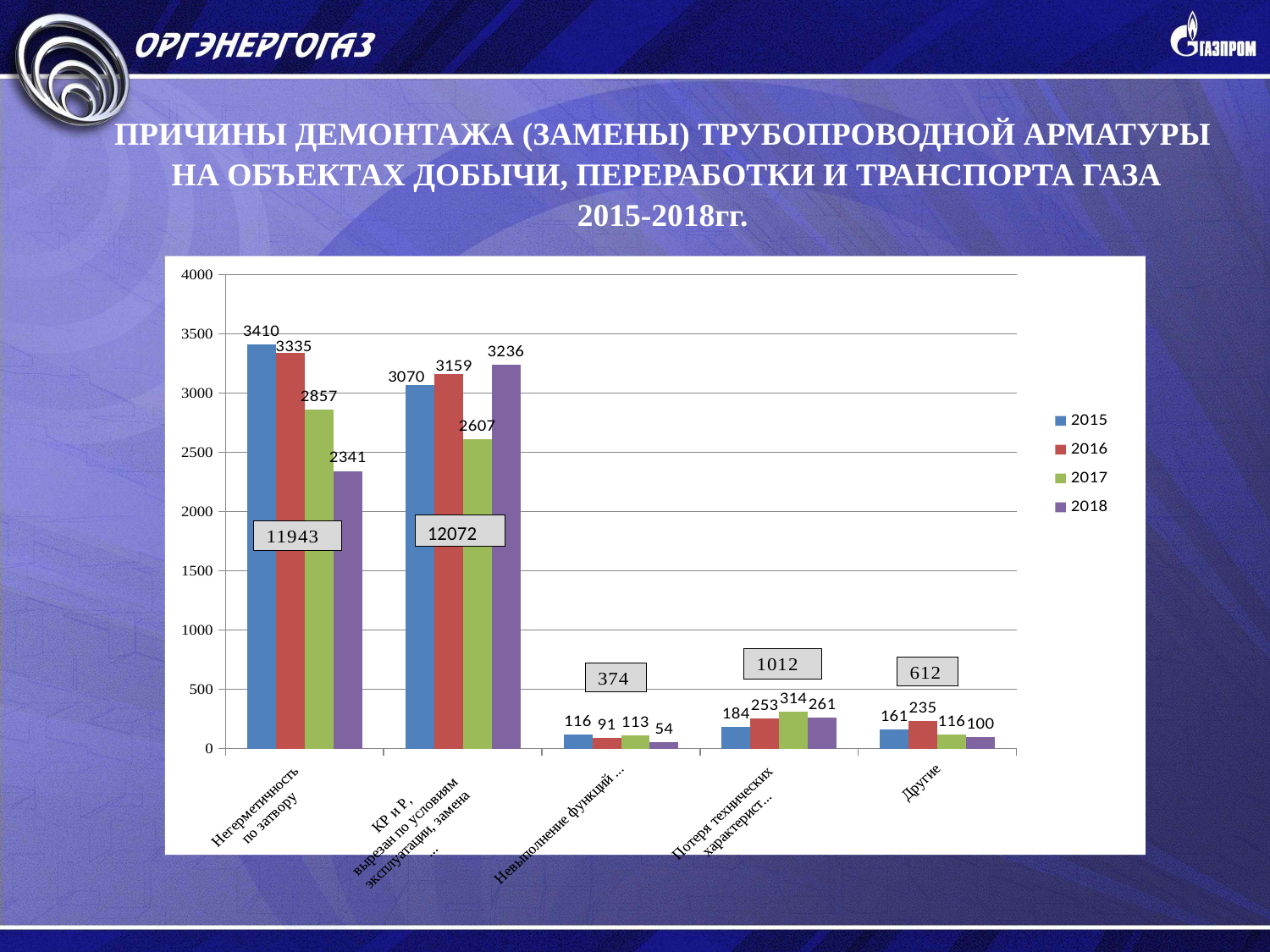
Which year has the highest value for "Негерметичность по затвору"? 2015 What total is shown in the box above the "Другие" bars? 612 What is the 2018 value for "Негерметичность по затвору"? 2341 Is the 2017 value for "Негерметичность по затвору" greater or less than 3000? less Which year has the lowest value for "Другие"? 2018 How many series does the legend list? 4 Which is larger for "Другие": the 2015 value or the 2016 value? 2016 How many categories are shown on the x axis? 5 What type of chart is shown on the slide? bar chart What is the 2015 value for "Негерметичность по затвору"? 3410 What is the difference between the 2015 and 2018 values for "Негерметичность по затвору"? 1069 What is the 2016 value for "Другие"? 235